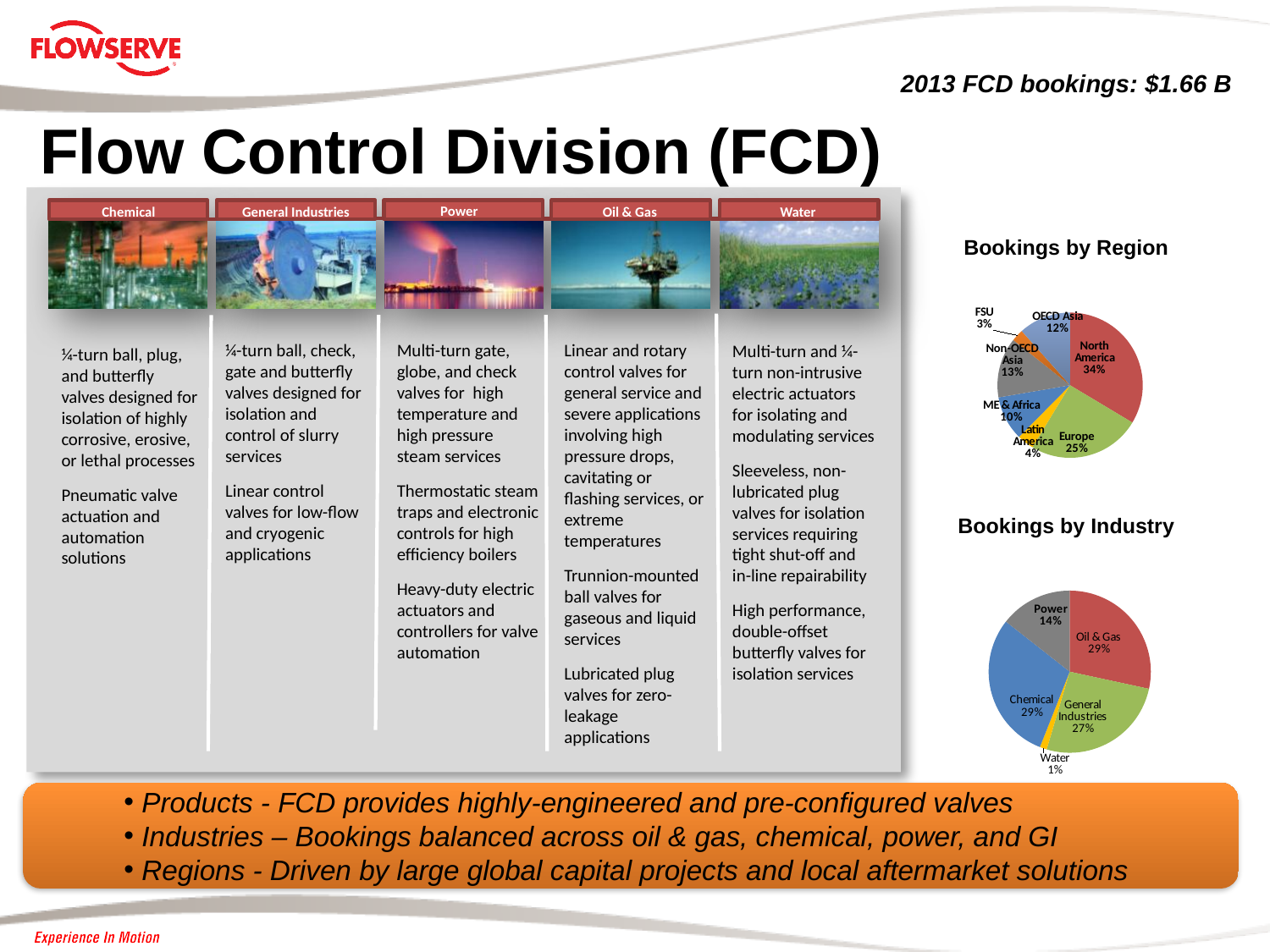
In the Bookings by Region chart, what share of bookings comes from Europe? 25% In the Bookings by Industry chart, what share of bookings comes from General Industries? 27% In the Bookings by Region chart, which is larger, Non-OECD Asia or ME & Africa? Non-OECD Asia In the Bookings by Region chart, how many regions are shown? 7 What type of chart is the Bookings by Industry chart? Pie chart In the Bookings by Region chart, what is the difference in percentage points between North America and Europe? 9 In the Bookings by Region chart, which region has the largest share of bookings? North America In the Bookings by Region chart, which region has the smallest share of bookings? FSU In the Bookings by Industry chart, how many industries are shown? 5 In the Bookings by Industry chart, which industry has the smallest share of bookings? Water In the Bookings by Region chart, what share of bookings comes from North America? 34% In the Bookings by Industry chart, what share of bookings comes from Power? 14%